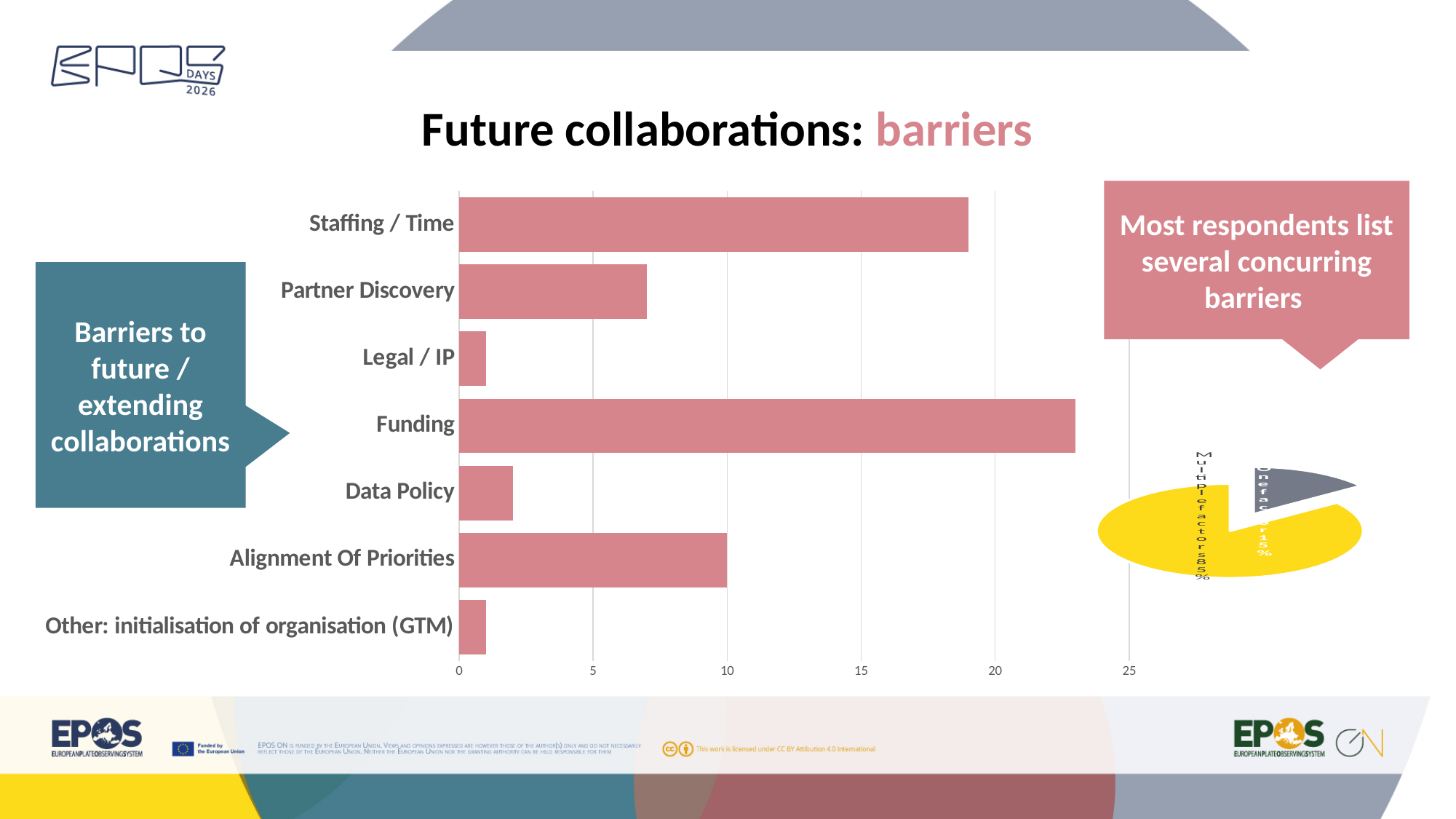
What kind of chart is used to show the barriers to future collaborations? bar chart In the bar chart, is the value for Funding greater or less than 20? greater In the bar chart, is the value for Staffing / Time greater or less than 15? greater In the pie chart on the right, what share of respondents list multiple factors? 85% In the bar chart, is the value for Data Policy greater or less than 5? less In the bar chart, which is larger: Alignment Of Priorities or Data Policy? Alignment Of Priorities In the bar chart, which barrier has the longest bar? Funding In the bar chart, which is larger: Staffing / Time or Partner Discovery? Staffing / Time How many barrier categories are shown in the bar chart? 7 What is the title of the slide containing the barriers bar chart? Future collaborations: barriers